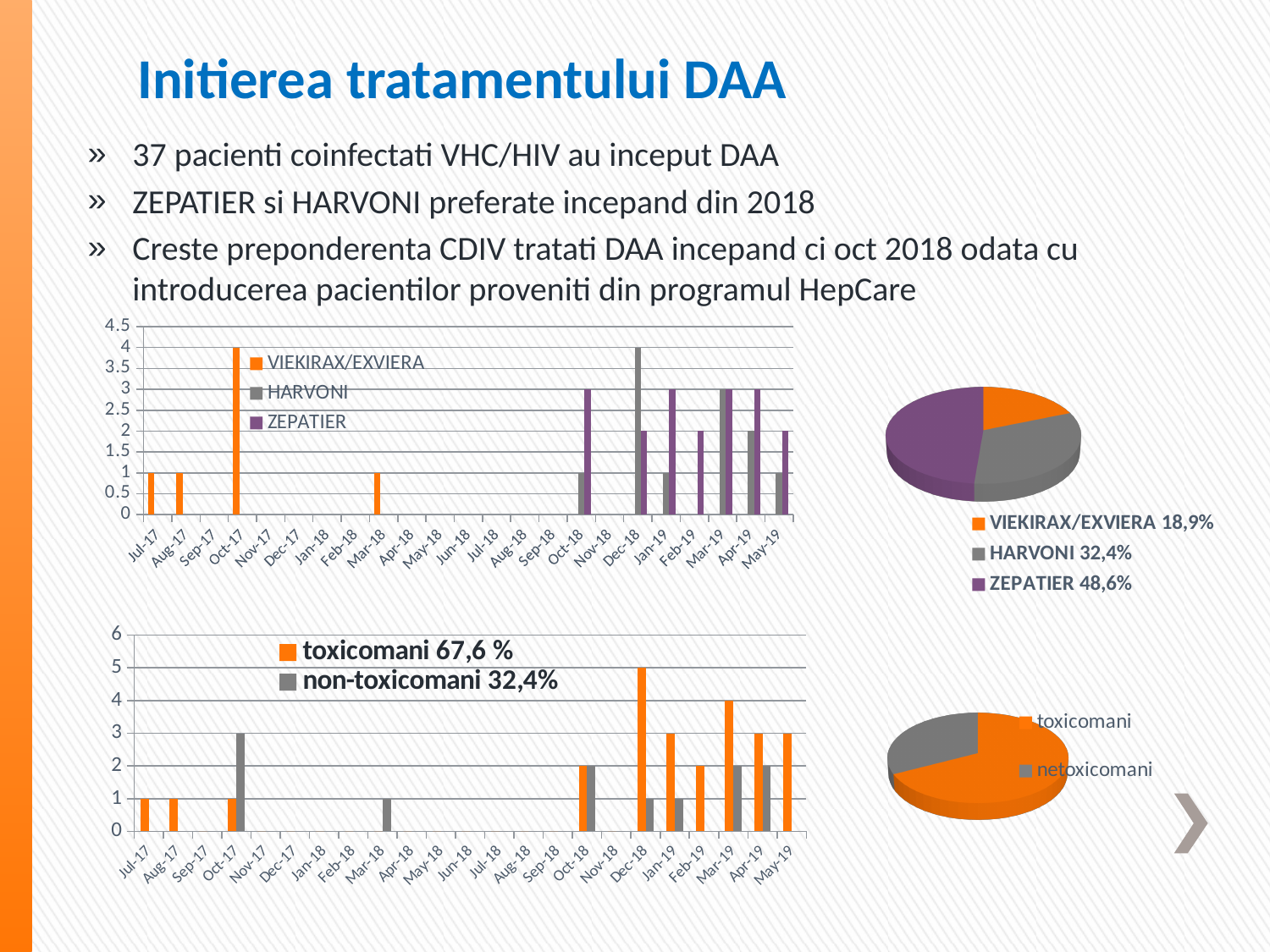
In the top-right pie chart, which drug has the smallest slice? VIEKIRAX/EXVIERA What percentage is shown for toxicomani in the legend of the bottom-left bar chart? 67,6 % In the bottom-left bar chart, which month has the highest toxicomani value? Dec-18 How many series does the legend of the top-left bar chart list? 3 What kind of chart is the top-right chart? pie chart In the top-left bar chart, what is the value for HARVONI in Dec-18? 4 In the top-left bar chart, what is the value for VIEKIRAX/EXVIERA in Oct-17? 4 In the top-right pie chart, which drug has the largest slice? ZEPATIER In the bottom-left bar chart, in Oct-17 which is larger, toxicomani or non-toxicomani? non-toxicomani In the bottom-left bar chart, what is the value for toxicomani in Dec-18? 5 In the top-right pie chart, what share does ZEPATIER have? 48,6% In the top-right pie chart, what is the difference between the HARVONI share and the VIEKIRAX/EXVIERA share? 13,5%